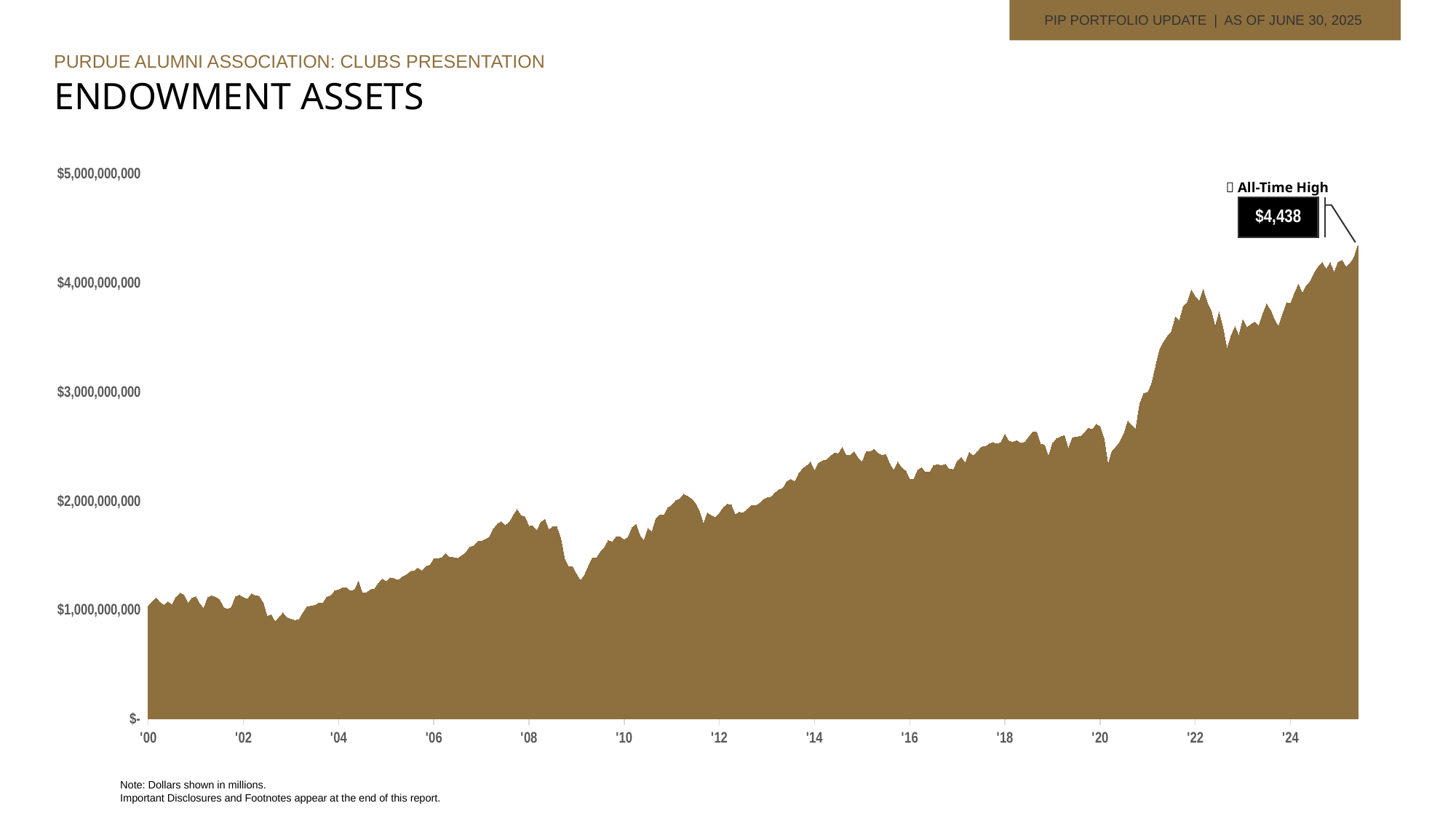
Is the value at '20 greater or less than $3,000,000,000? less Is the value at '22 greater or less than $3,000,000,000? greater What is the highest value shown on the y axis? $5,000,000,000 Is the value at '08 greater or less than $2,000,000,000? less What is the all-time high value labelled on the chart? $4,438 How many year labels are shown on the x axis? 13 Overall, do endowment assets rise or fall from '00 to the end of the chart? rise What kind of chart is shown on the slide? area chart What is the title of the chart on the slide? ENDOWMENT ASSETS